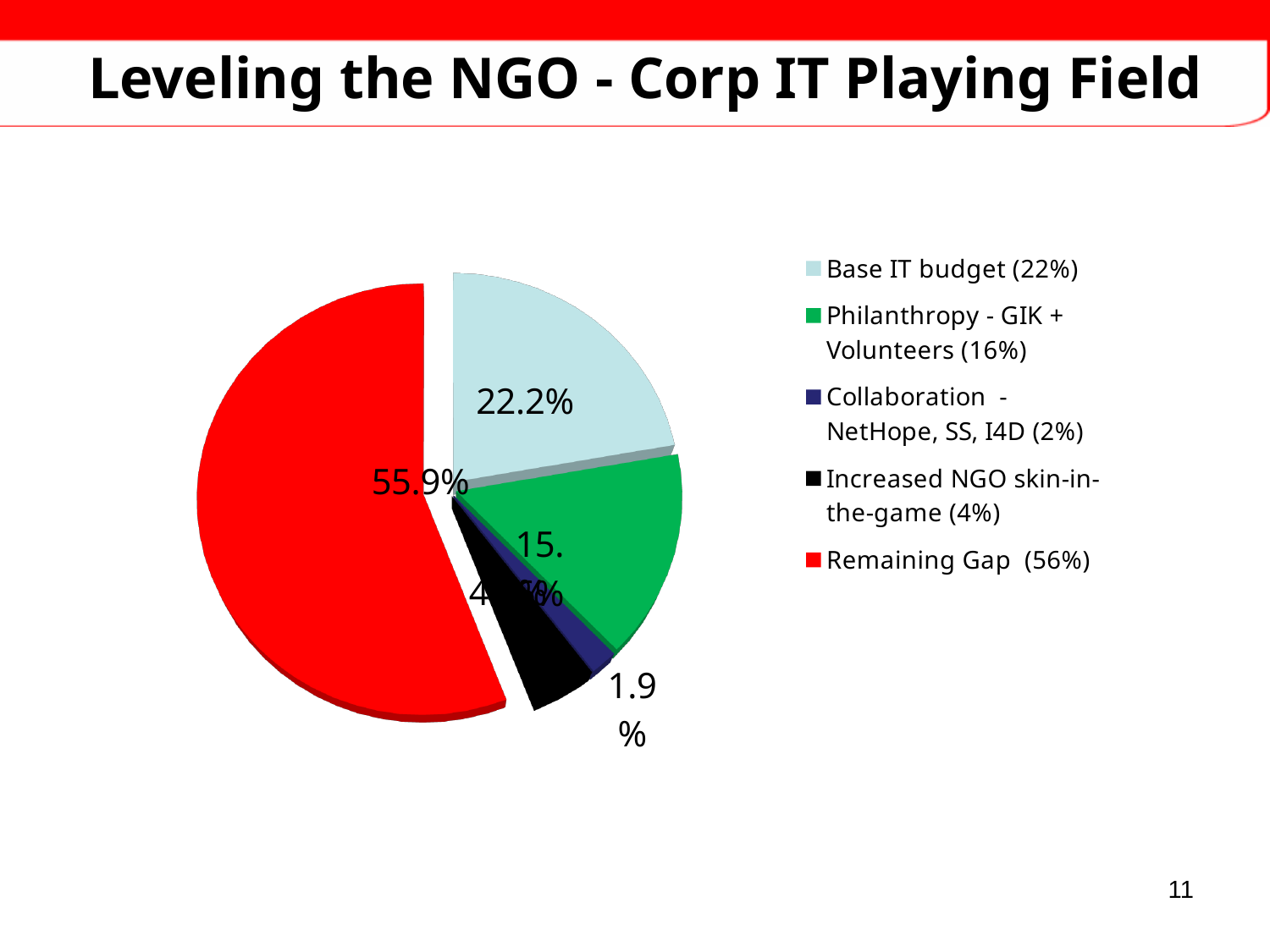
How many slices does the pie chart have? 5 Which category has the smallest slice of the pie? Collaboration - NetHope, SS, I4D What is the data label shown on the Base IT budget slice? 22.2% How many entries does the legend list? 5 What is the difference in percentage points between the Remaining Gap slice (55.9%) and the Base IT budget slice (22.2%)? 33.7 Which category has the largest slice of the pie? Remaining Gap What is the data label shown on the Collaboration - NetHope, SS, I4D slice? 1.9% What percentage does the legend give for Philanthropy - GIK + Volunteers? 16% What colour is the Remaining Gap slice? red What is the data label shown on the Remaining Gap slice? 55.9% Which slice is larger: Base IT budget or Philanthropy - GIK + Volunteers? Base IT budget What kind of chart is shown on the slide? pie chart